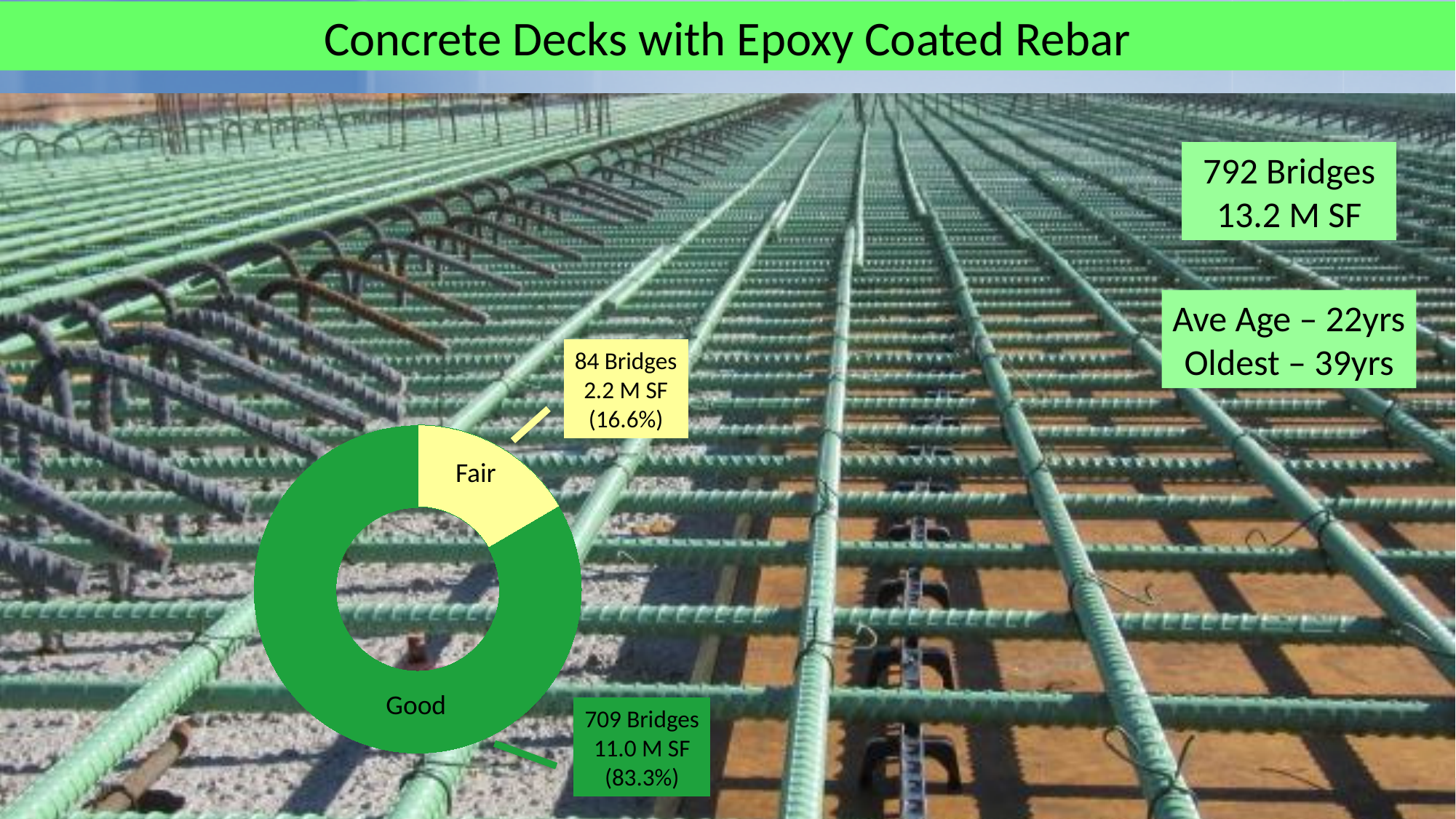
How many bridges are in the Fair category? 84 Bridges Which category has the larger number of bridges, Good or Fair? Good What is the square footage shown for the Fair category? 2.2 M SF What is the square footage shown for the Good category? 11.0 M SF What kind of chart is shown on the slide? Doughnut chart How many bridges are in the Good category? 709 Bridges How many more bridges are in the Good category than in the Fair category? 625 What share of the chart does the Fair slice represent? 16.6% How many categories does the chart show? 2 What colour is the Fair slice of the chart? Yellow Which category has the smallest share of the chart? Fair What share of the chart does the Good slice represent? 83.3%